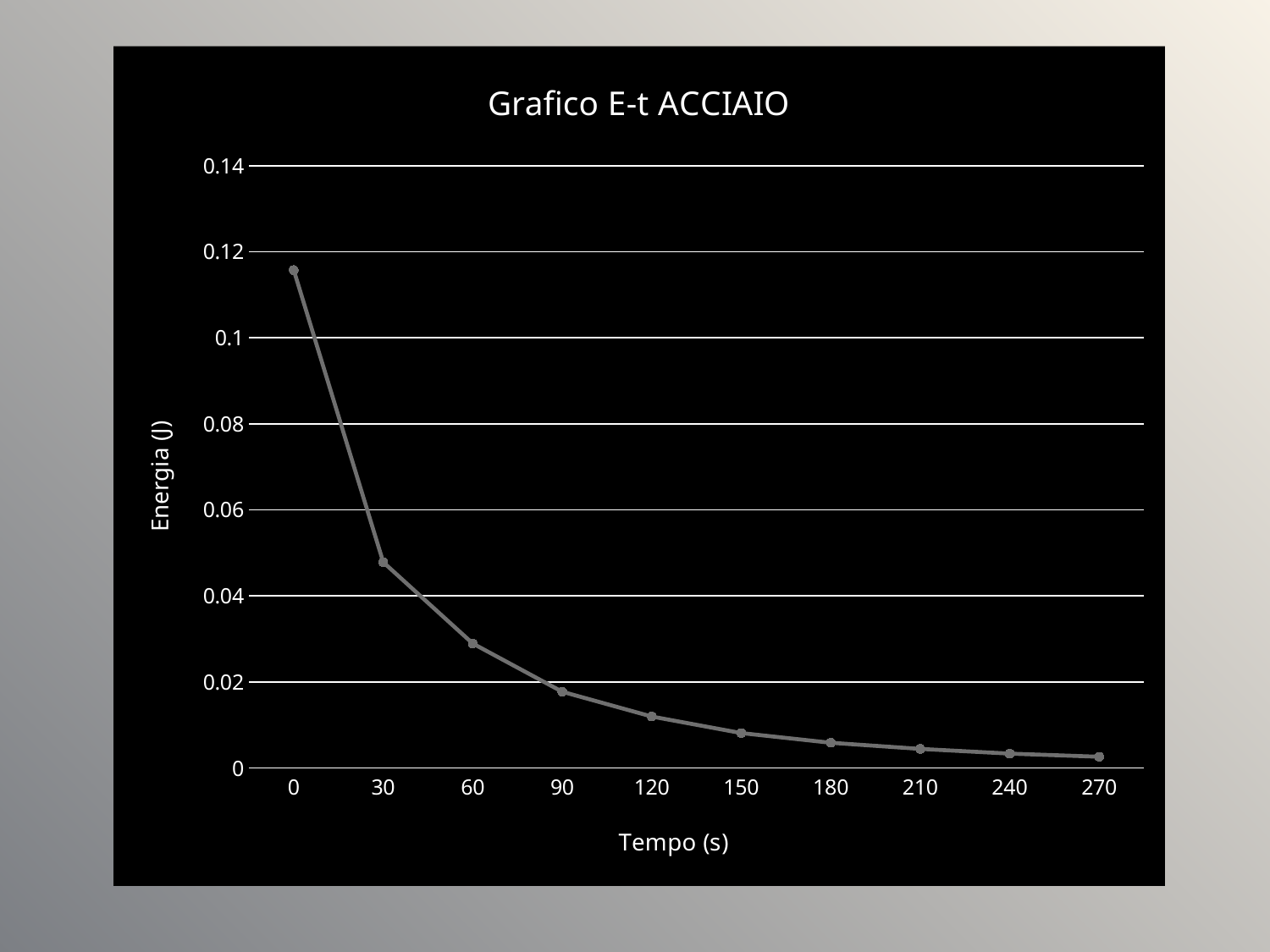
Is the value at Tempo 0 s greater or less than 0.12? less Which has the larger energy value, Tempo 30 s or Tempo 90 s? 30 What is the label of the y axis? Energia (J) Is the value at Tempo 30 s greater or less than 0.06? less At which Tempo (s) value is the energy lowest? 270 Is the value at Tempo 0 s greater or less than 0.1? greater Do the values rise or fall as Tempo (s) increases along the x axis? fall What is the title of the chart? Grafico E-t ACCIAIO How many data points are plotted on the line? 10 At which Tempo (s) value is the energy highest? 0 What kind of chart is shown on the slide? line chart